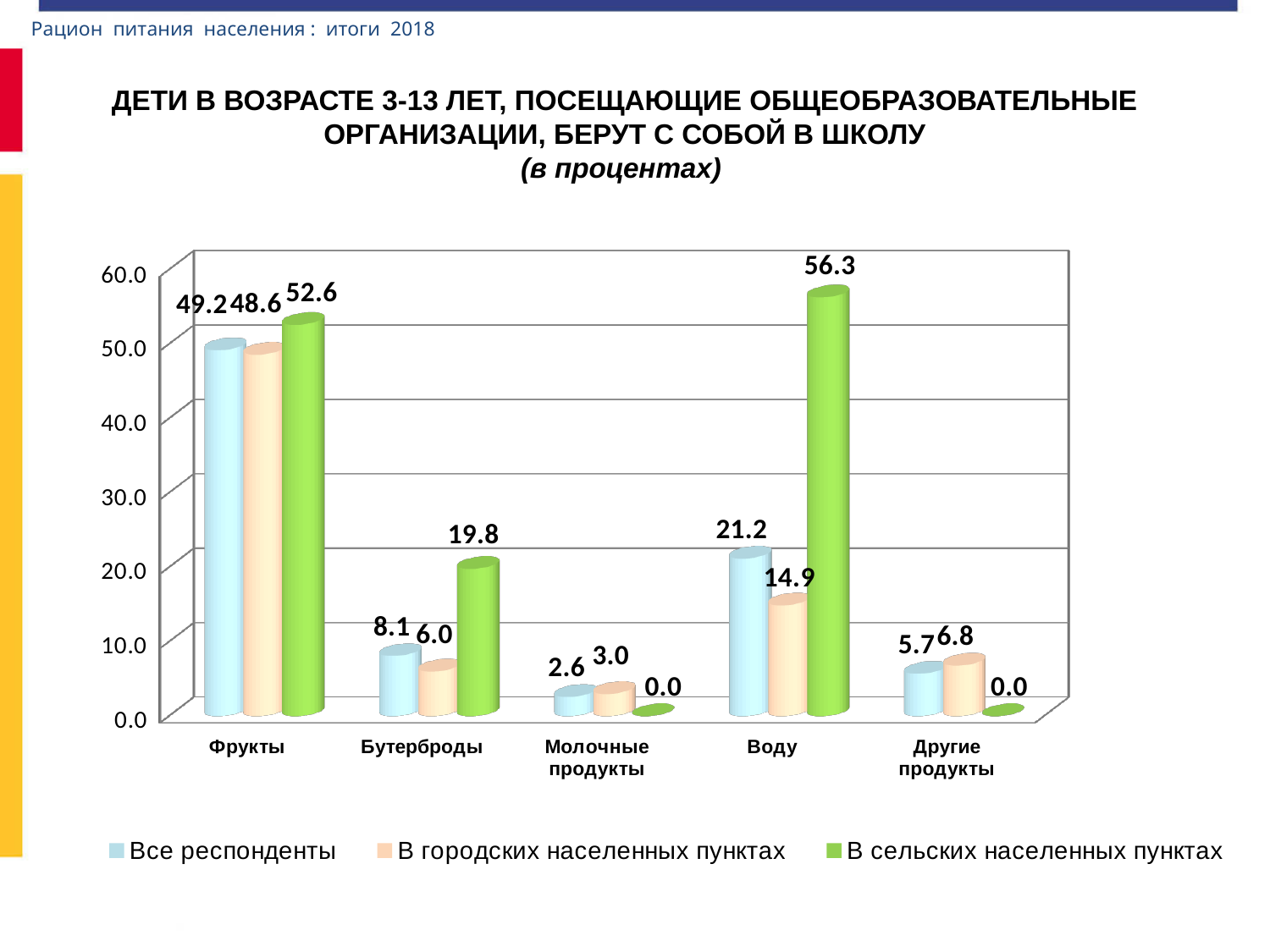
What is the value for Воду in the series В сельских населенных пунктах? 56.3 Which category has the lowest value in the series Все респонденты? Молочные продукты How many categories are shown on the x axis? 5 What is the value for Бутерброды in the series В городских населенных пунктах? 6.0 What is the value for Фрукты in the series Все респонденты? 49.2 Is the value for Фрукты in the series В сельских населенных пунктах greater or less than 50.0? greater What kind of chart is shown on the slide? bar chart Which category has the highest value in the series В сельских населенных пунктах? Воду Which series is shown in green in the legend? В сельских населенных пунктах What is the difference between the values for Воду in the series В сельских населенных пунктах and Все респонденты? 35.1 How many series does the legend list? 3 Which is larger for Бутерброды: the value for Все респонденты or for В сельских населенных пунктах? В сельских населенных пунктах